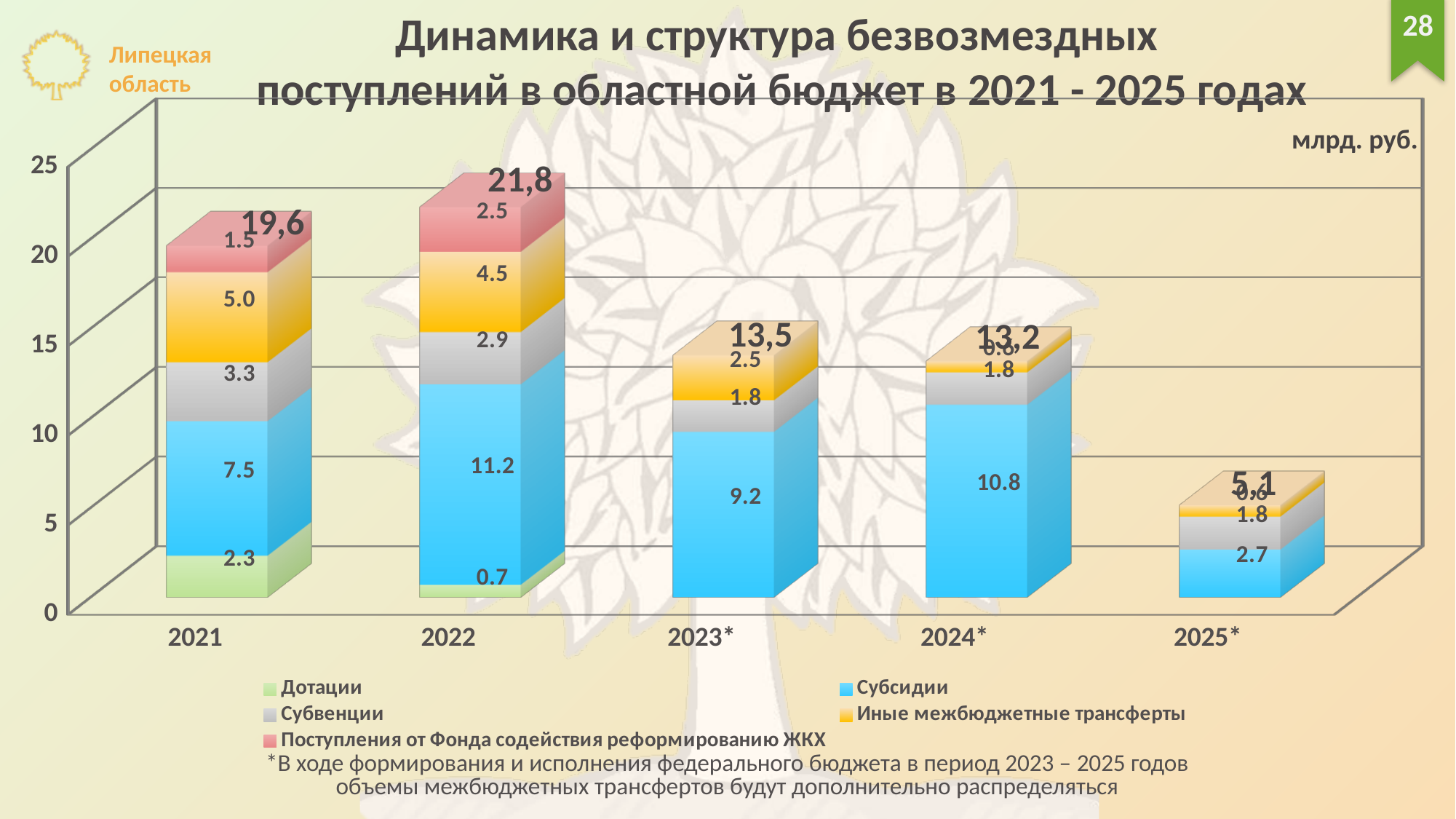
How many series does the legend list? 5 What is the total value shown above the bar for 2025*? 5,1 Which year has the lowest total of безвозмездные поступления? 2025* What is the value of Субсидии for 2024*? 10.8 What is the value of Дотации for 2022? 0.7 What is the value of Поступления от Фонда содействия реформированию ЖКХ for 2022? 2.5 What is the difference between the total for 2022 and the total for 2021? 2,2 Which year has the highest total of безвозмездные поступления? 2022 What is the value of Субсидии for 2021? 7.5 What kind of chart is shown on the slide? Stacked bar chart Is the value of Субсидии larger in 2022 or in 2023*? 2022 What is the total value shown above the bar for 2022? 21,8